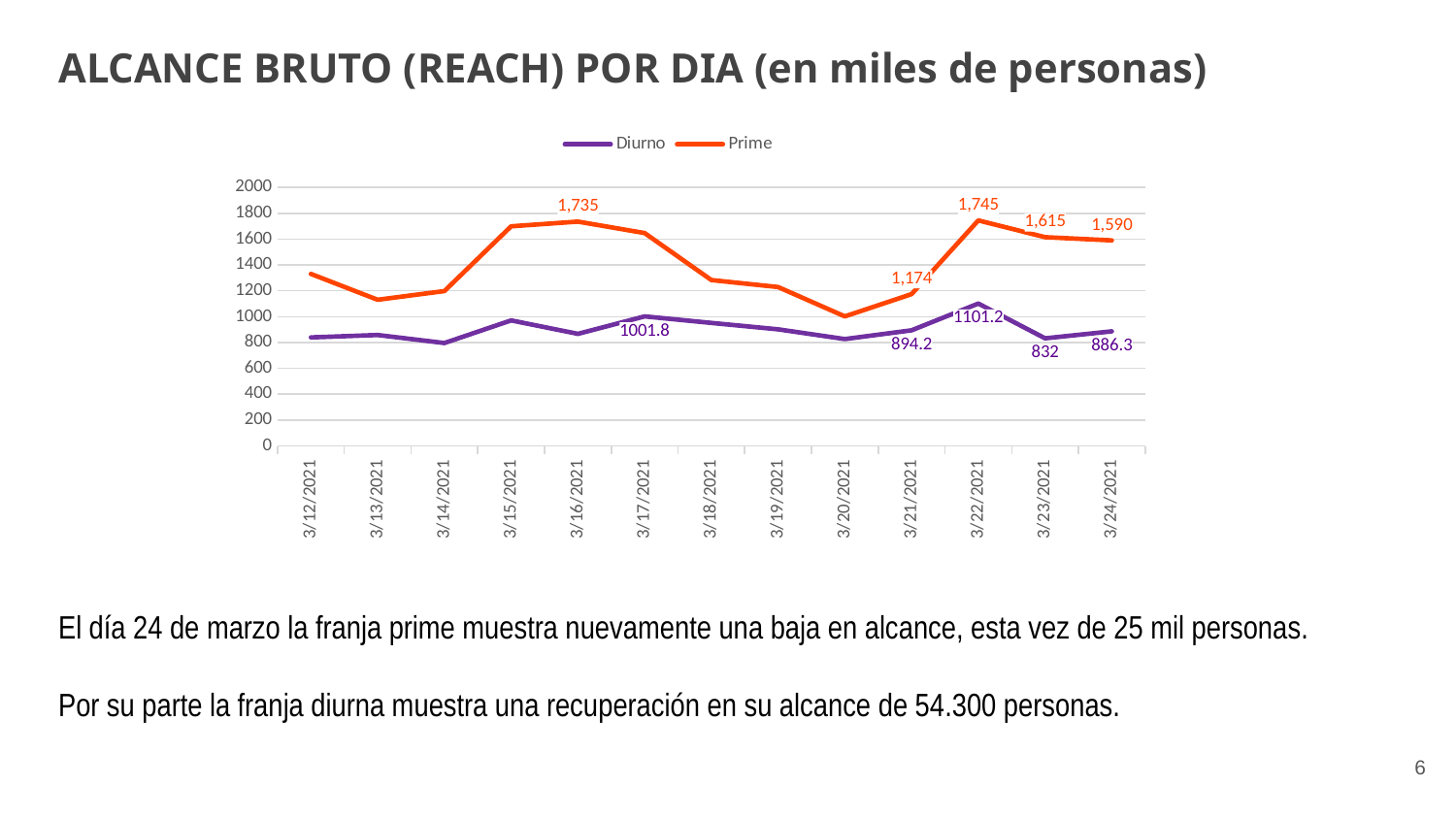
What is the Diurno value on 3/17/2021? 1001.8 What kind of chart is shown on the slide? line chart What is the Diurno value on 3/23/2021? 832 Is the Prime value on 3/13/2021 greater or less than 1400? less What is the Prime value on 3/22/2021? 1,745 How many series does the legend list? 2 Which series is drawn in orange? Prime What is the difference between the Diurno values on 3/24/2021 and 3/23/2021? 54.3 How many dates are plotted along the x axis? 13 Which series is higher on 3/21/2021, Diurno or Prime? Prime What is the difference between the Prime values on 3/23/2021 and 3/24/2021? 25 What is the Prime value on 3/24/2021? 1,590